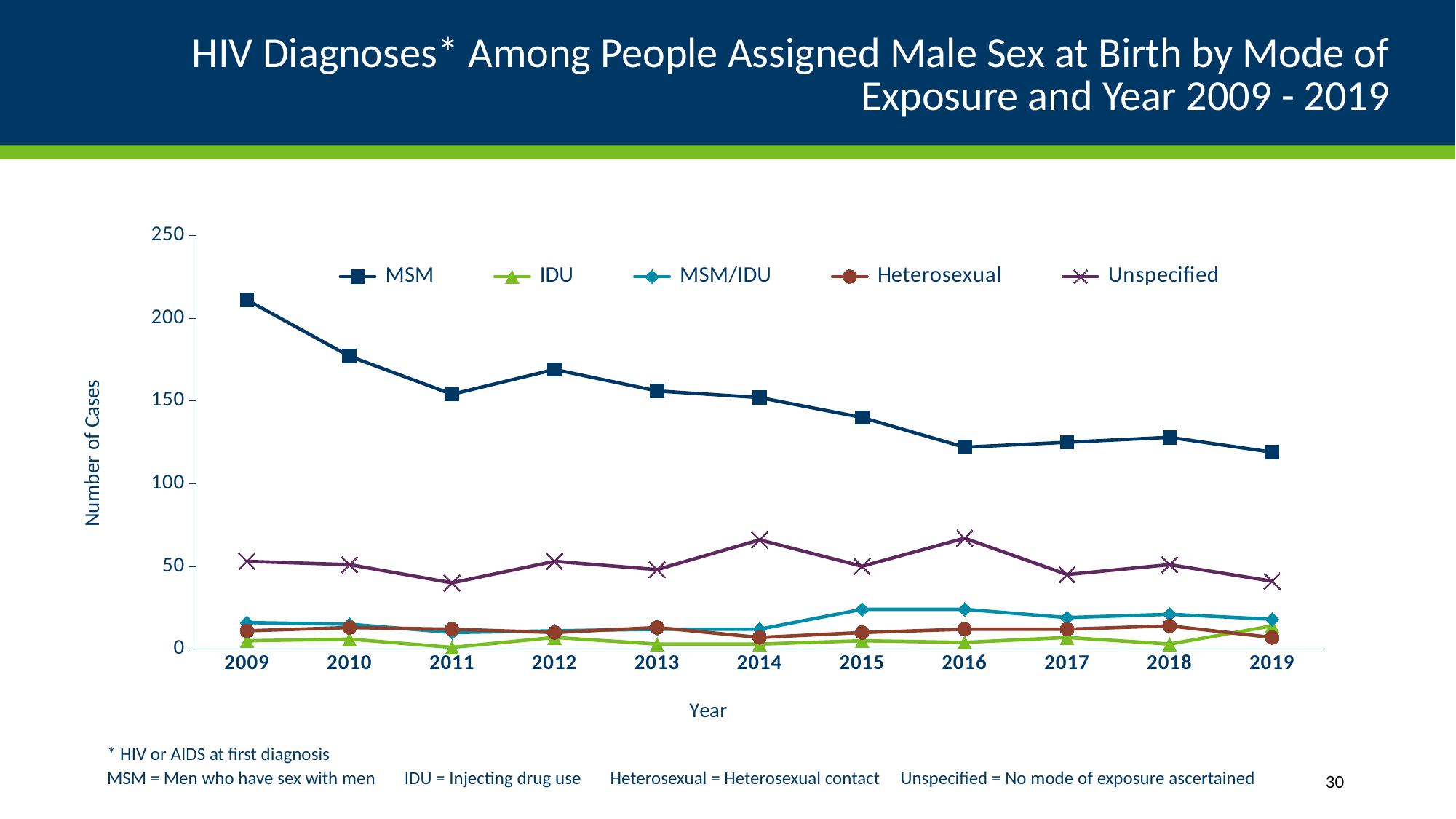
Is the value for MSM/IDU in 2015 greater or less than 50? less Does the MSM series generally rise or fall from 2009 to 2019? Fall How many series does the legend list? 5 How many years are plotted along the x axis? 11 What kind of chart is shown on the slide? Line chart Which series has the highest number of cases in every year shown? MSM What is the title of the vertical axis? Number of Cases Is the value for Unspecified in 2016 greater or less than 50? greater Is the value for MSM in 2009 greater or less than 200? greater Which is larger in 2015, the value for MSM/IDU or the value for Heterosexual? MSM/IDU In which year is the MSM series at its highest? 2009